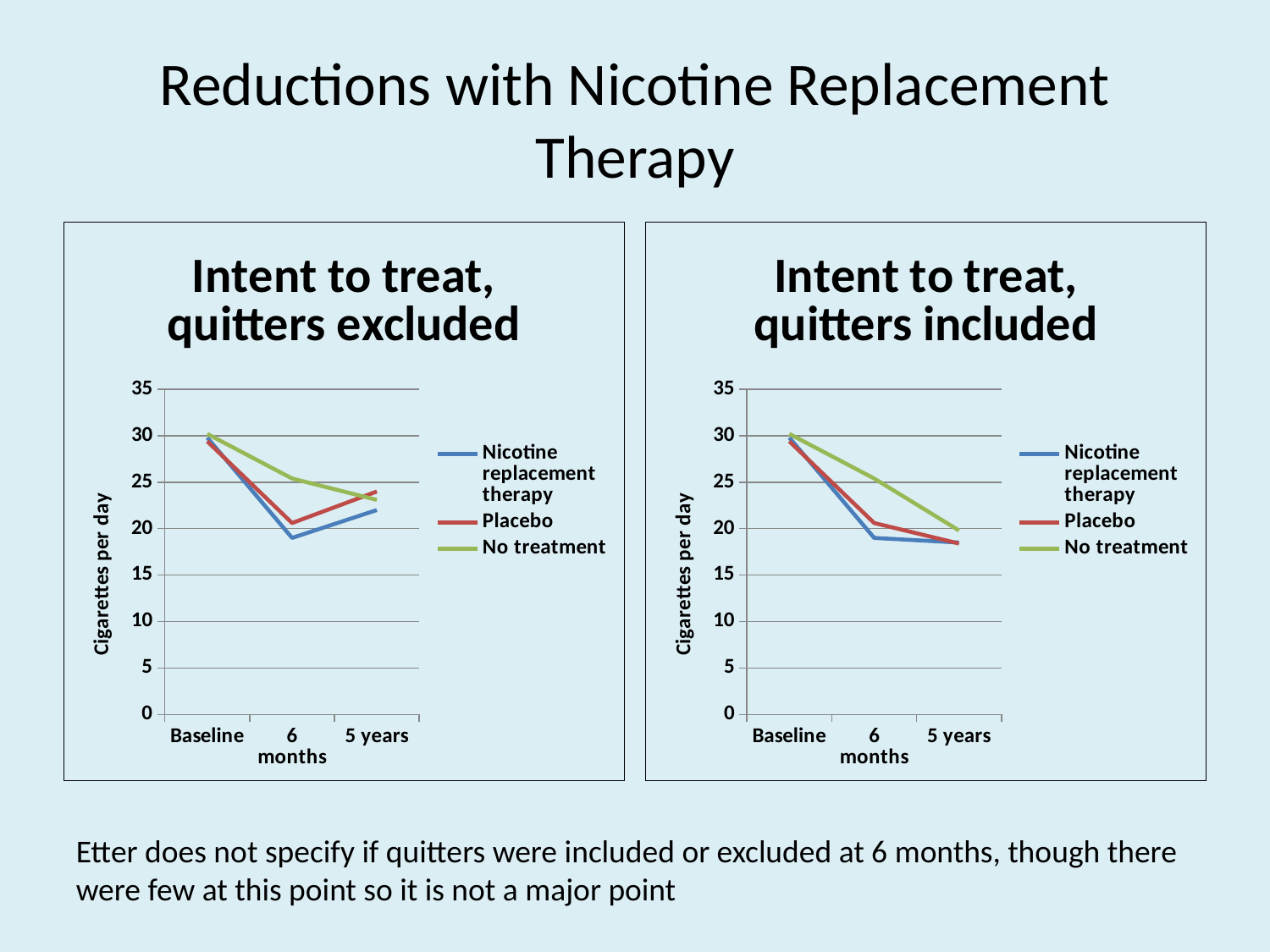
In the "Intent to treat, quitters included" chart, is the Placebo value larger at 6 months or at 5 years? 6 months In the "Intent to treat, quitters excluded" chart, which series has the lowest value at 6 months? Nicotine replacement therapy In the "Intent to treat, quitters included" chart, does the No treatment line rise or fall from Baseline to 5 years? fall In the "Intent to treat, quitters excluded" chart, is the value for Nicotine replacement therapy at 6 months greater or less than 20? less What is the y-axis label of the "Intent to treat, quitters excluded" chart? Cigarettes per day How many series does the legend of the "Intent to treat, quitters included" chart list? 3 How many time points are shown on the x axis of the "Intent to treat, quitters excluded" chart? 3 In the "Intent to treat, quitters excluded" chart, does the Nicotine replacement therapy line rise or fall from Baseline to 6 months? fall What kind of chart is the "Intent to treat, quitters excluded" chart? line chart In the "Intent to treat, quitters excluded" chart, which series has the highest value at 6 months? No treatment In the "Intent to treat, quitters included" chart, is the value for No treatment at 6 months greater or less than 20? greater In the "Intent to treat, quitters included" chart, which series has the highest value at 5 years? No treatment